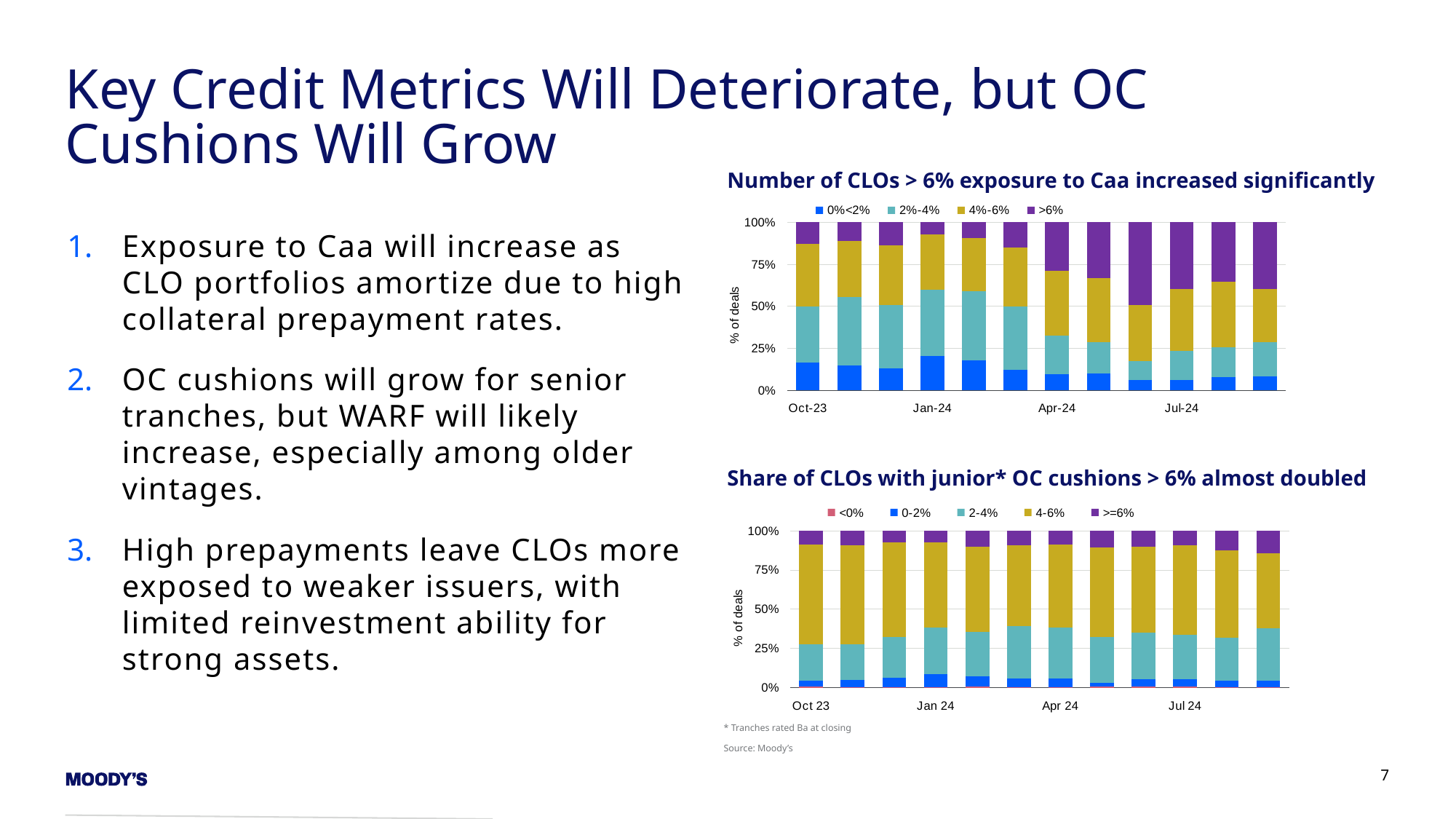
In the top chart on Caa exposure, is the combined share of the "0%<2%" and "2%-4%" categories for Jan-24 greater or less than 50%? greater What kind of chart is the top chart titled "Number of CLOs > 6% exposure to Caa increased significantly"? Stacked bar chart How many series does the legend of the top chart (Caa exposure) list? 4 In the top chart on Caa exposure, what does each full stacked bar add up to? 100% In the bottom chart on junior OC cushions, is the combined share of all categories up to "4-6%" for Oct 23 greater or less than 75%? greater What is the label on the vertical axis of the bottom chart on junior OC cushions? % of deals In the top chart on Caa exposure, is the "0%<2%" segment for Oct-23 greater or less than 25%? less Which legend entry in the bottom chart on junior OC cushions is shown in purple? >=6% In the top chart on Caa exposure, does the share of the ">6%" category rise or fall from Oct-23 to the last month shown? Rise How many series does the legend of the bottom chart (junior OC cushions) list? 5 How many bars (months) are plotted in the top chart on Caa exposure? 12 How many bars (months) are plotted in the bottom chart on junior OC cushions? 12